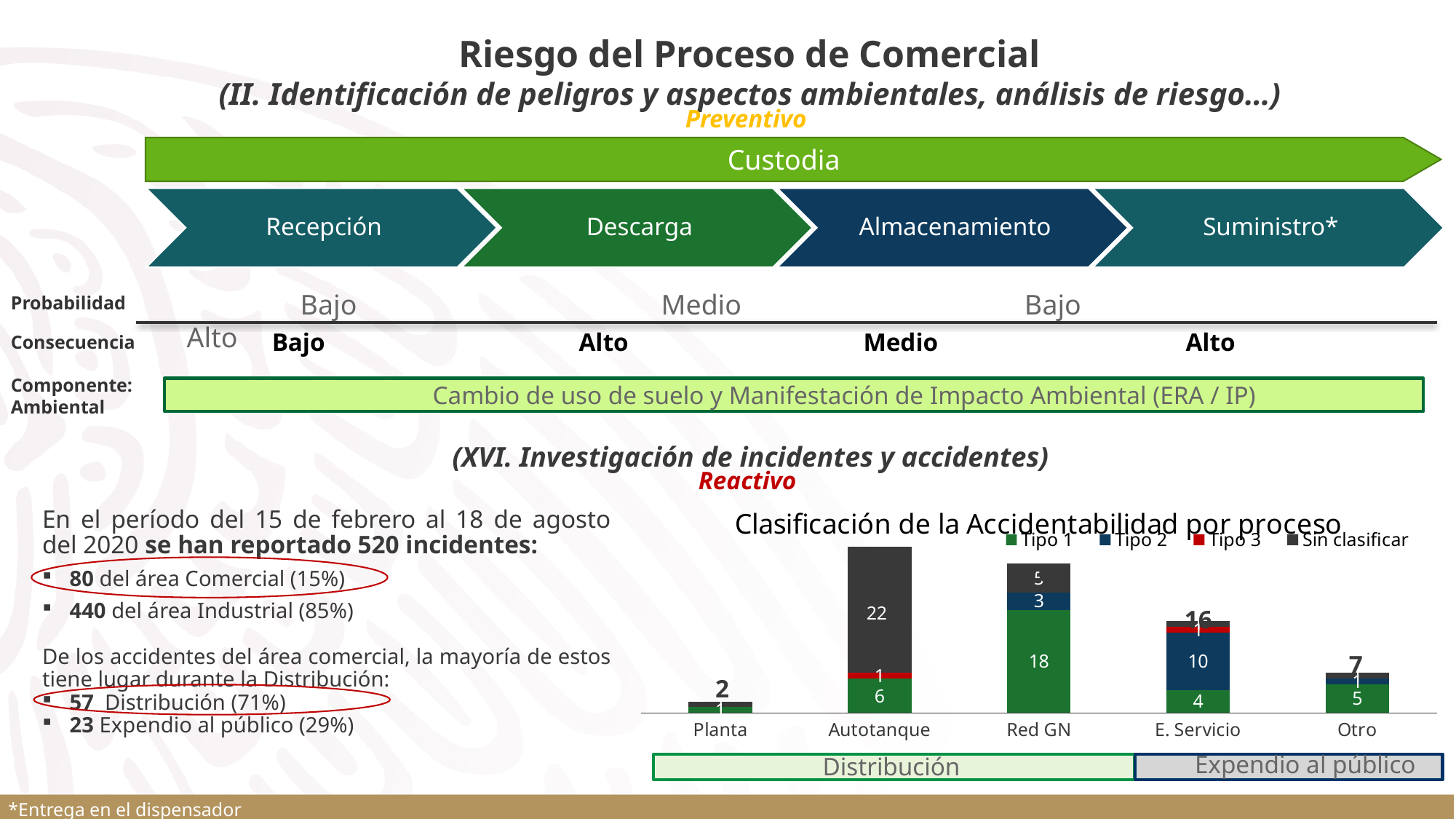
In the 'Clasificación de la Accidentabilidad por proceso' chart, which category has the tallest stacked bar? Autotanque How many series does the legend of the 'Clasificación de la Accidentabilidad por proceso' chart list? 4 In the 'Clasificación de la Accidentabilidad por proceso' chart, what is the total shown above the Otro bar? 7 In the 'Clasificación de la Accidentabilidad por proceso' chart, what is the Tipo 1 value for Autotanque? 6 In the 'Clasificación de la Accidentabilidad por proceso' chart, which category has the shortest stacked bar? Planta In the 'Clasificación de la Accidentabilidad por proceso' chart, what is the total shown above the E. Servicio bar? 16 In the 'Clasificación de la Accidentabilidad por proceso' chart, what is the difference between the Tipo 1 value for Red GN and the Tipo 1 value for Autotanque? 12 In the 'Clasificación de la Accidentabilidad por proceso' chart, what is the Tipo 1 value for Red GN? 18 What kind of chart is 'Clasificación de la Accidentabilidad por proceso'? Stacked bar chart In the 'Clasificación de la Accidentabilidad por proceso' chart, what is the Sin clasificar value for Autotanque? 22 In the 'Clasificación de la Accidentabilidad por proceso' chart, what is the Tipo 2 value for E. Servicio? 10 How many categories are shown on the x axis of the 'Clasificación de la Accidentabilidad por proceso' chart? 5